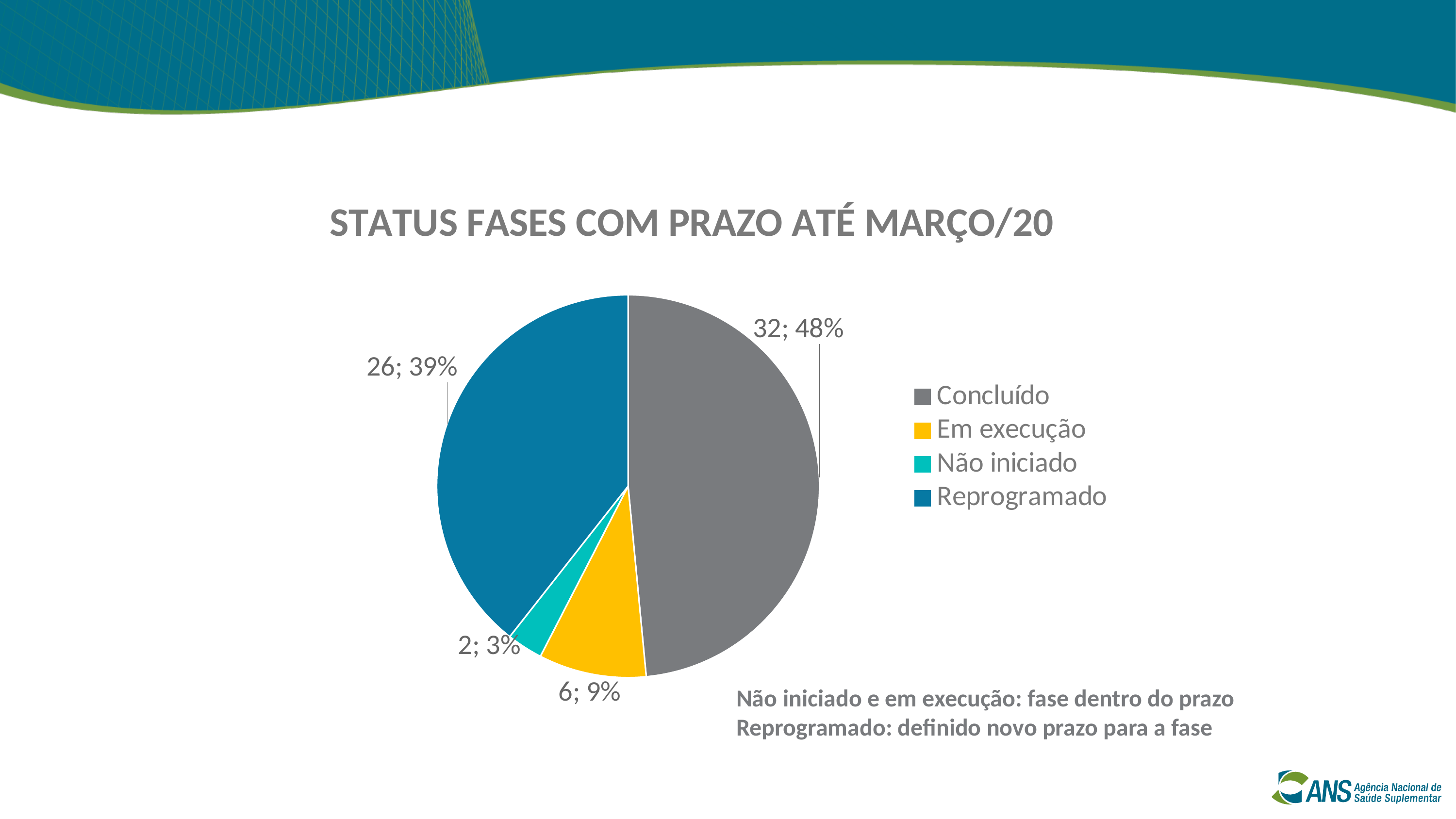
Which category has the smallest slice? Não iniciado What colour is the Reprogramado slice? blue Which category has the largest slice? Concluído What is the count for Concluído? 32 What type of chart is shown on the slide? pie chart Which is larger, Em execução or Não iniciado? Em execução What is the count for Em execução? 6 What is the difference in count between Concluído and Reprogramado? 6 How many categories does the legend list? 4 What is the title of the chart? STATUS FASES COM PRAZO ATÉ MARÇO/20 What percentage share does Não iniciado have? 3% What percentage share does Reprogramado have? 39%